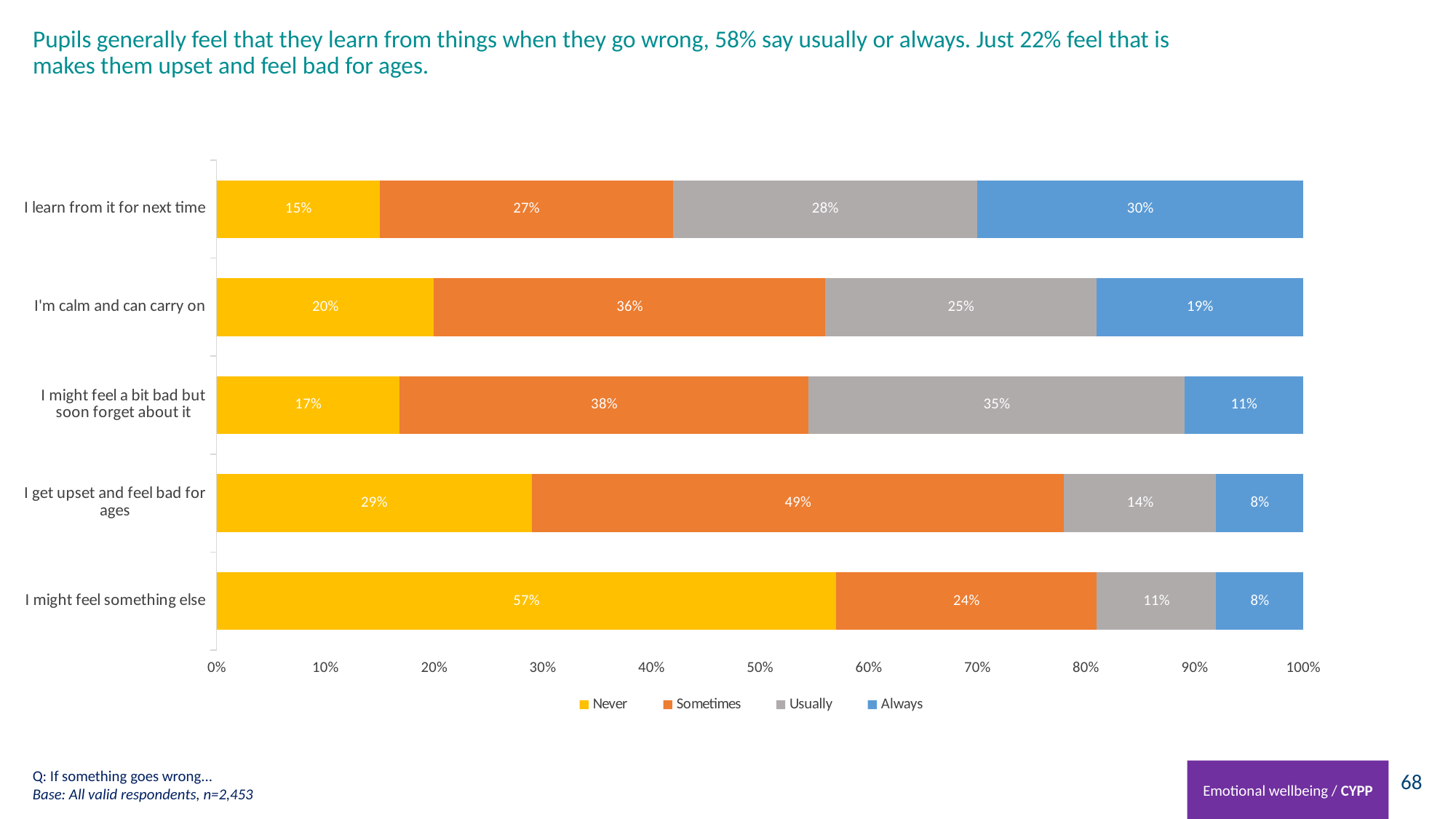
What is the 'Usually' value for 'I might feel a bit bad but soon forget about it'? 35% What is the combined 'Usually' and 'Always' value for 'I learn from it for next time'? 58% How many categories are shown on the chart? 5 What percentage of pupils say they 'Always' learn from it for next time? 30% What is the 'Never' value for 'I might feel something else'? 57% What kind of chart is shown on the slide? Stacked bar chart Which category has the highest 'Never' value? I might feel something else Which category has the lowest 'Usually' value? I might feel something else What is the 'Sometimes' value for 'I get upset and feel bad for ages'? 49% How many series does the legend list? 4 What is the difference between the 'Sometimes' values for 'I get upset and feel bad for ages' and 'I learn from it for next time'? 22% Which is larger: the 'Always' value for 'I'm calm and can carry on' or for 'I might feel a bit bad but soon forget about it'? I'm calm and can carry on